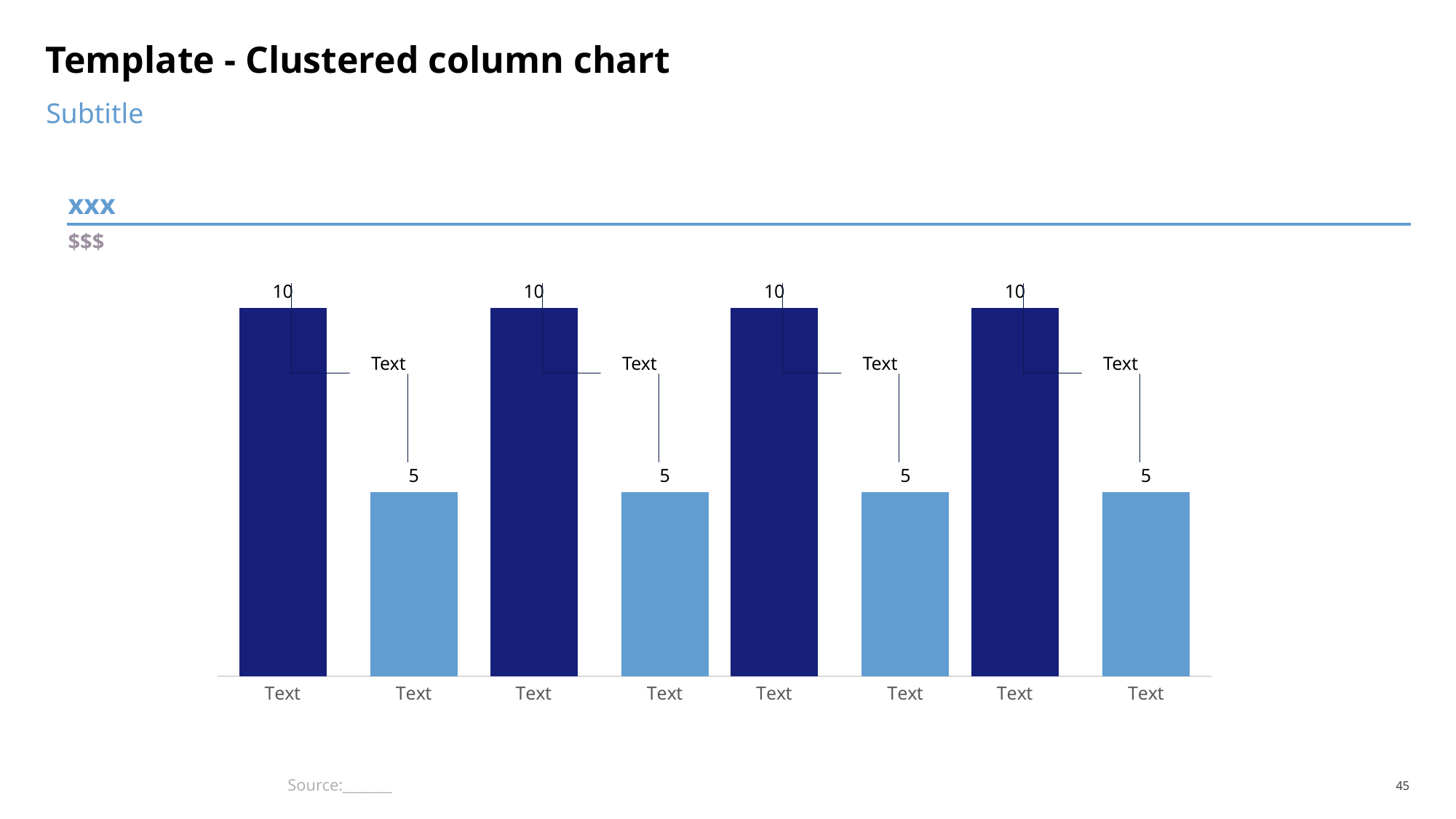
What value is labelled on each of the dark blue bars? 10 How many bars are plotted in the chart? 8 What is the value of the rightmost bar in the chart? 5 What is the value of the leftmost bar in the chart? 10 What is the title shown above the chart? xxx What is the difference between the value of the leftmost bar and the second bar from the left? 5 What is the highest value labelled on any bar in the chart? 10 What is the value of the second bar from the left in the chart? 5 Which is larger, the leftmost bar or the second bar from the left? the leftmost bar What kind of chart is shown on the slide? bar chart What is the lowest value labelled on any bar in the chart? 5 What value is labelled on each of the light blue bars? 5